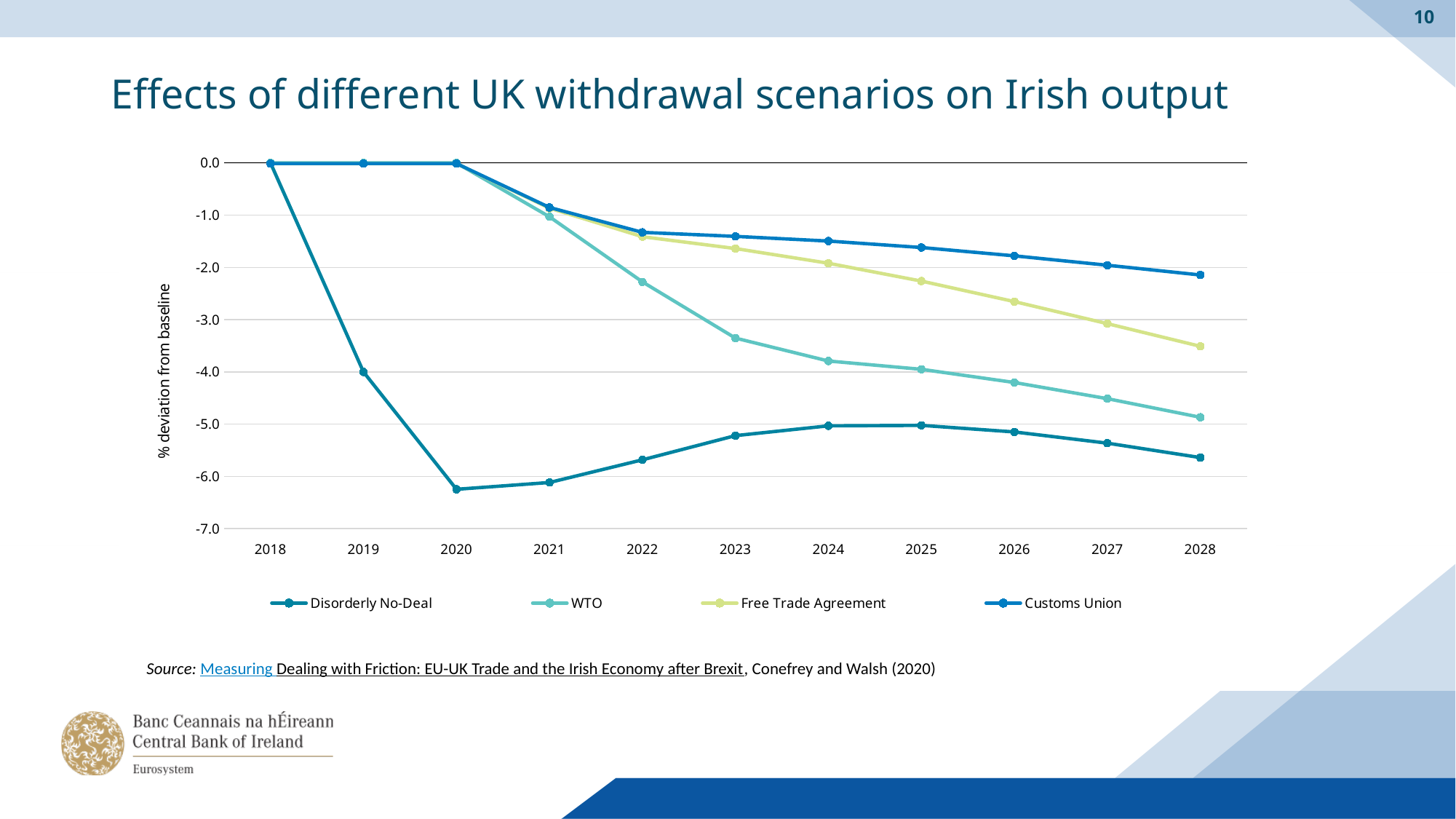
Does the Customs Union line rise or fall from 2021 to 2028? Fall Which scenario has the highest value in 2028? Customs Union How many series does the legend list? 4 How many years are shown on the x axis? 11 Is the value for Disorderly No-Deal in 2020 greater or less than -6.0? less Is the value for Free Trade Agreement in 2028 greater or less than -3.0? less What is the label on the y axis? % deviation from baseline Which is larger in 2025, the value for WTO or the value for Free Trade Agreement? Free Trade Agreement What kind of chart is shown on the slide? Line chart What is the value for WTO in 2020? 0.0 What is the value for Disorderly No-Deal in 2019? -4.0 Which scenario has the lowest value in 2028? Disorderly No-Deal